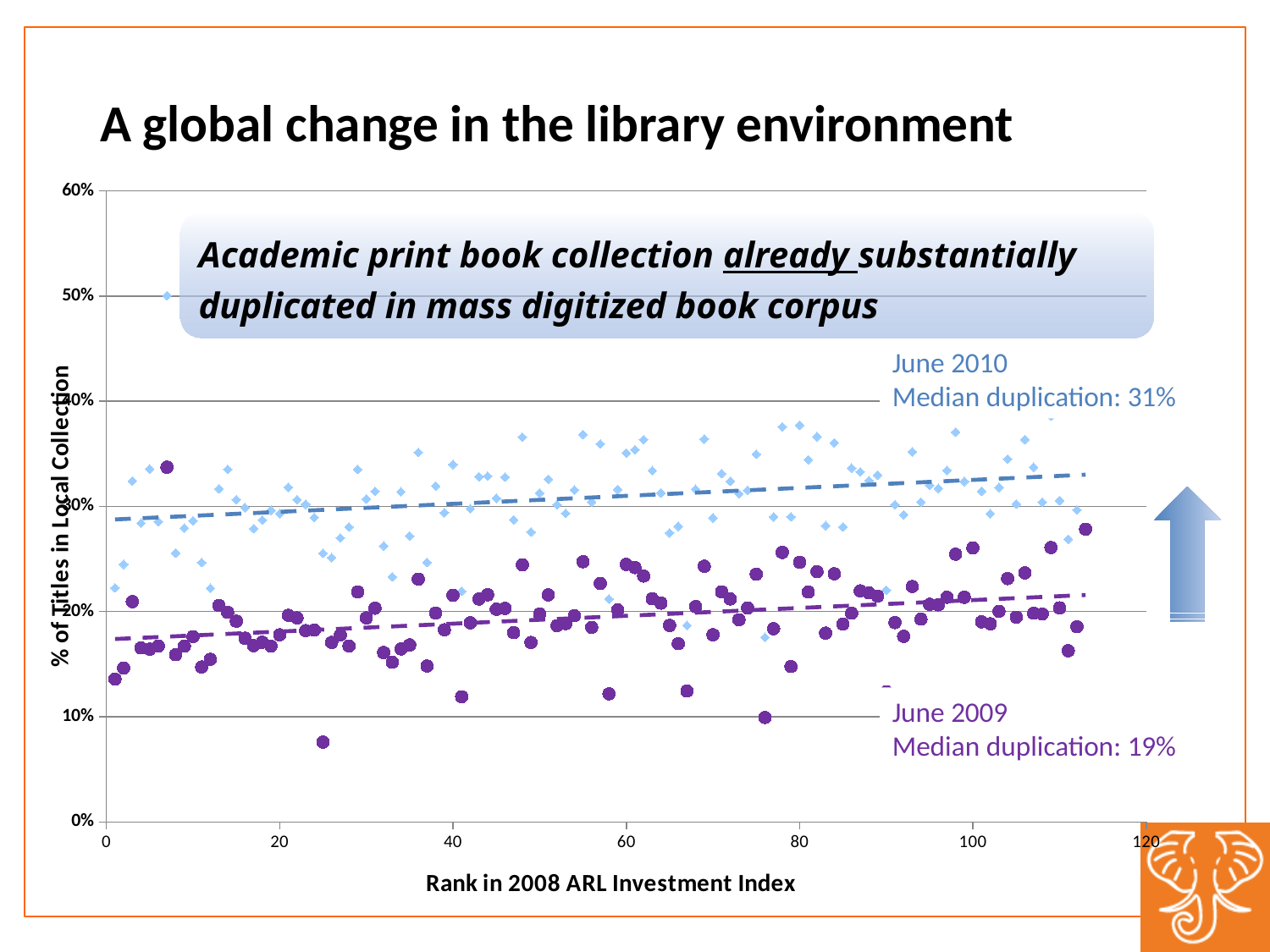
What is the label of the x axis? Rank in 2008 ARL Investment Index Which series has the higher median duplication, June 2010 or June 2009? June 2010 What is the label of the y axis? % of Titles in Local Collection What is the median duplication for June 2009? 19% Is the highest June 2009 value greater or less than 30%? greater What is the median duplication for June 2010? 31% What kind of chart is shown on the slide? scatter chart What is the difference between the June 2010 and June 2009 median duplication values? 12% Is the lowest June 2009 value greater or less than 10%? less How many data series are plotted on the chart? 2 Is the highest June 2010 value greater or less than 40%? greater Do the June 2010 values tend to rise or fall as rank increases along the x axis? rise